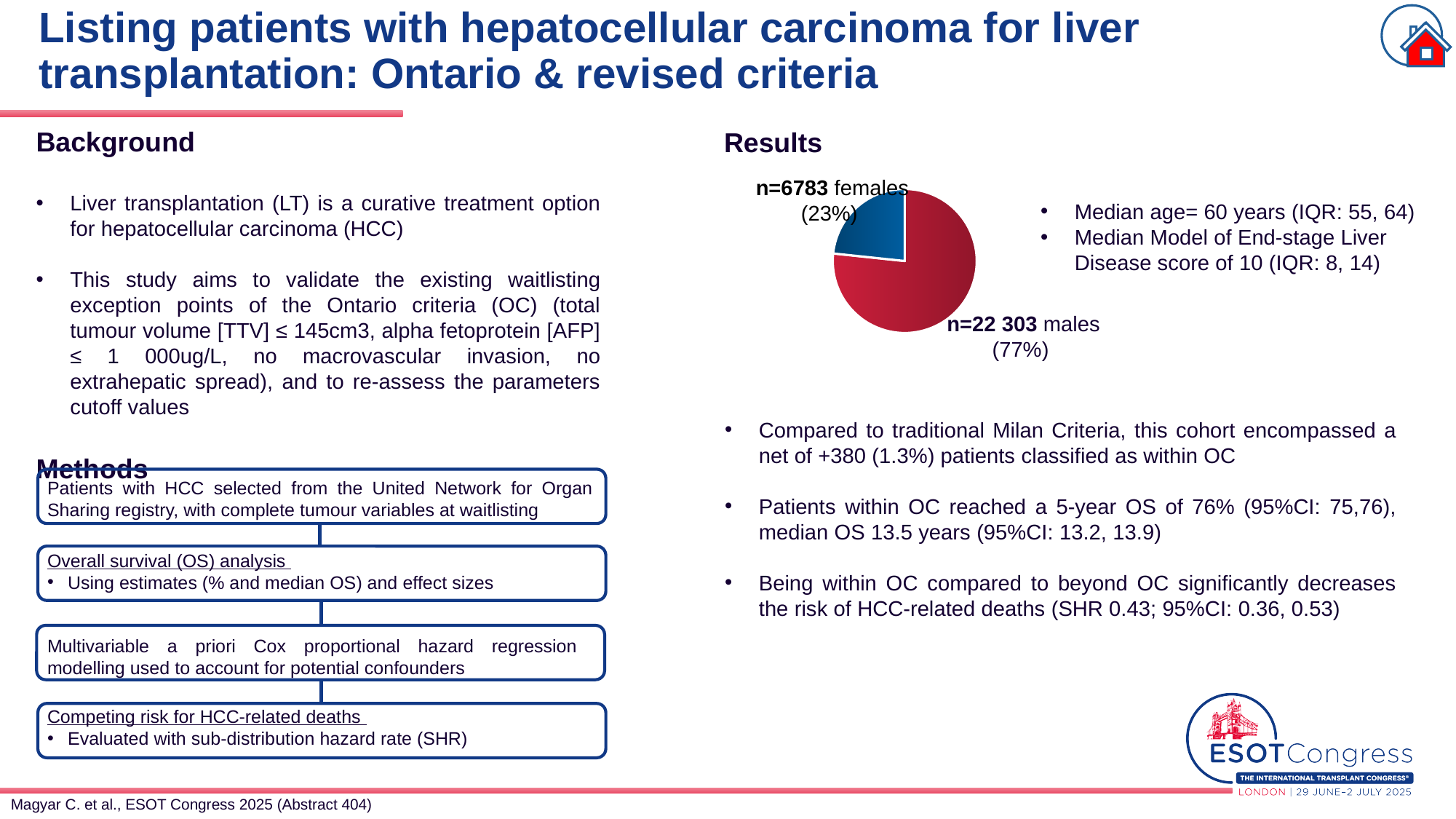
Which group is the smallest slice of the pie chart? females What share of the pie chart do females represent? 23% What is the total number of patients represented in the pie chart? 29 086 What kind of chart is shown in the Results section of the slide? pie chart Which group is the largest slice of the pie chart? males How many slices does the pie chart have? 2 What share of the pie chart do males represent? 77% What is the difference in patient numbers between males and females in the pie chart? 15 520 Which group is the larger slice of the pie chart, males or females? males What is the number of females shown in the pie chart? n=6783 What is the number of males shown in the pie chart? n=22 303 What colour is the males slice of the pie chart? red